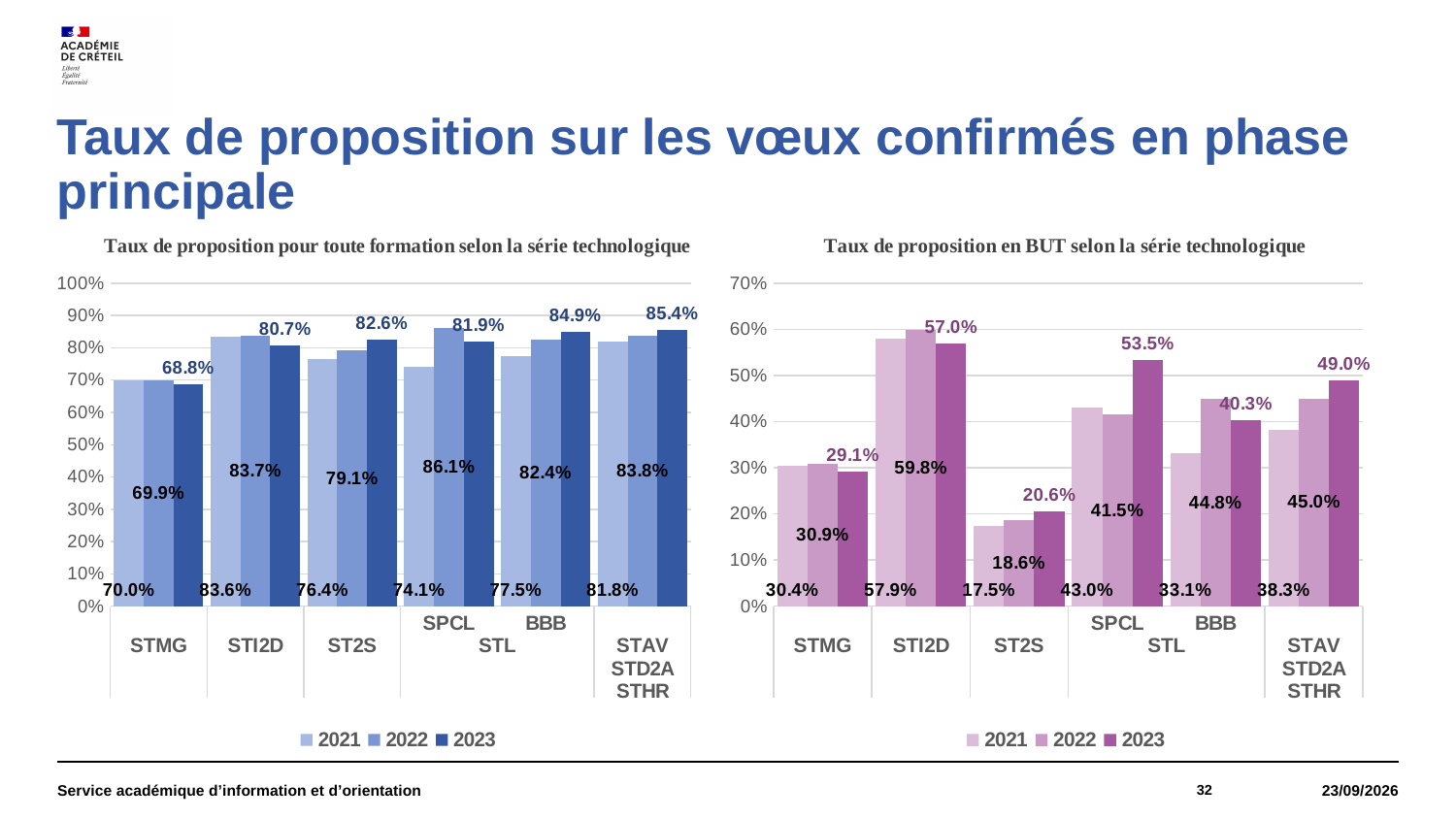
How many categories are shown on the x axis of the chart 'Taux de proposition en BUT selon la série technologique'? 6 What kind of chart is 'Taux de proposition pour toute formation selon la série technologique'? bar chart How many series does the legend list in the chart 'Taux de proposition en BUT selon la série technologique'? 3 In the chart 'Taux de proposition en BUT selon la série technologique', which is larger: the 2023 value for STL SPCL or the 2023 value for STAV STD2A STHR? STL SPCL In the chart 'Taux de proposition pour toute formation selon la série technologique', what is the value for STMG in 2023? 68.8% In the chart 'Taux de proposition pour toute formation selon la série technologique', which category has the highest value in 2023? STAV STD2A STHR In the chart 'Taux de proposition pour toute formation selon la série technologique', what is the difference between the 2022 and 2021 values for STL SPCL? 12.0 percentage points In the chart 'Taux de proposition pour toute formation selon la série technologique', do the values for ST2S rise or fall from 2021 to 2023? rise In the chart 'Taux de proposition en BUT selon la série technologique', which category has the lowest value in 2021? ST2S In the chart 'Taux de proposition pour toute formation selon la série technologique', what is the value for ST2S in 2021? 76.4% In the chart 'Taux de proposition en BUT selon la série technologique', what is the difference between the 2023 and 2021 values for STAV STD2A STHR? 10.7 percentage points In the chart 'Taux de proposition en BUT selon la série technologique', what is the value for STI2D in 2022? 59.8%